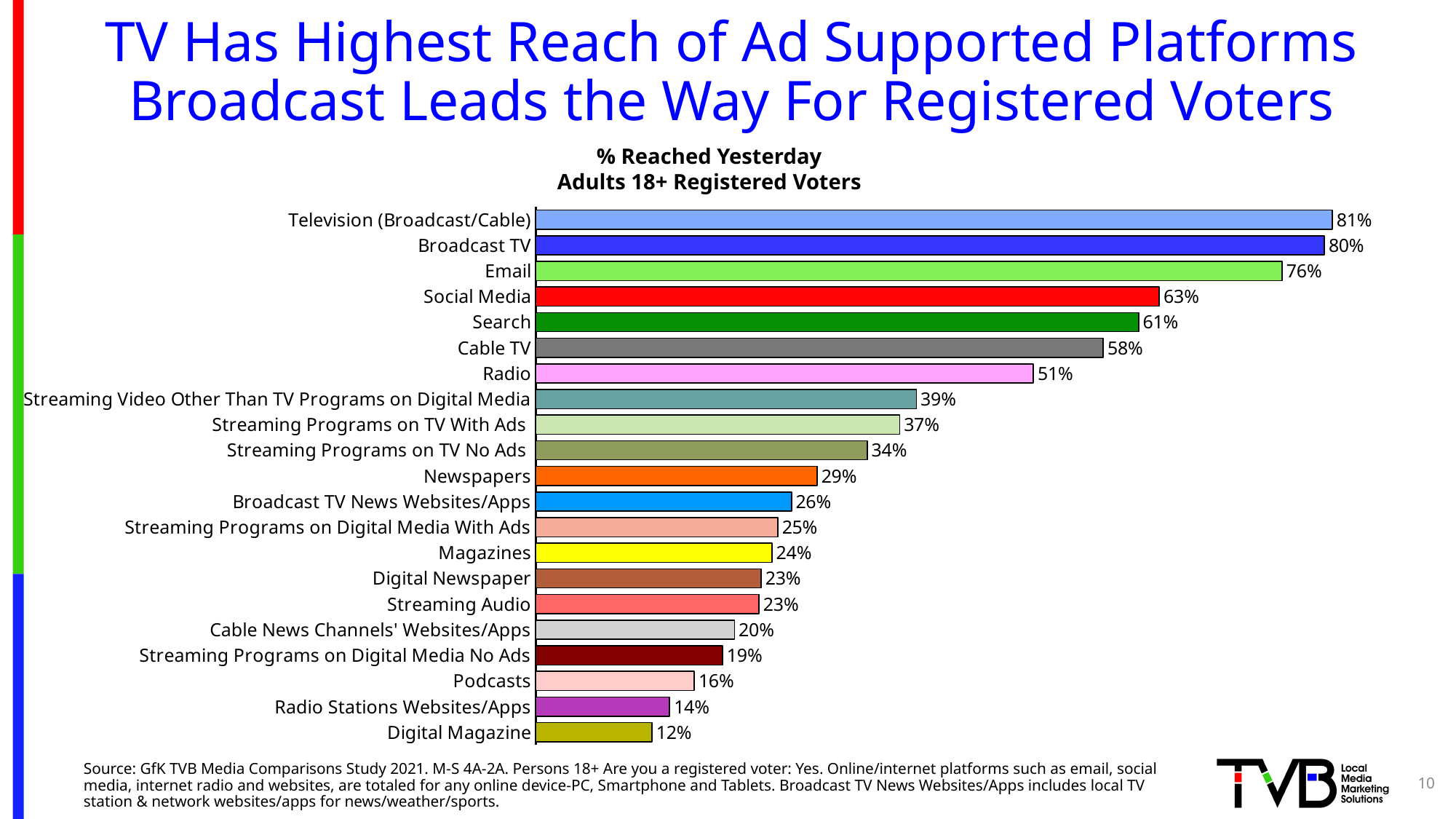
What is the value for Radio? 51% What kind of chart is this? Bar chart What is the value for Television (Broadcast/Cable)? 81% Which category has the lowest value? Digital Magazine What is the title of the chart? % Reached Yesterday Adults 18+ Registered Voters Which category has the highest value? Television (Broadcast/Cable) What is the difference between Streaming Programs on TV With Ads and Streaming Programs on TV No Ads? 3% Which is larger, Email or Social Media? Email What is the difference between Broadcast TV and Cable TV? 22% How many categories are shown in the chart? 21 Which is larger, Newspapers or Magazines? Newspapers What is the value for Podcasts? 16%